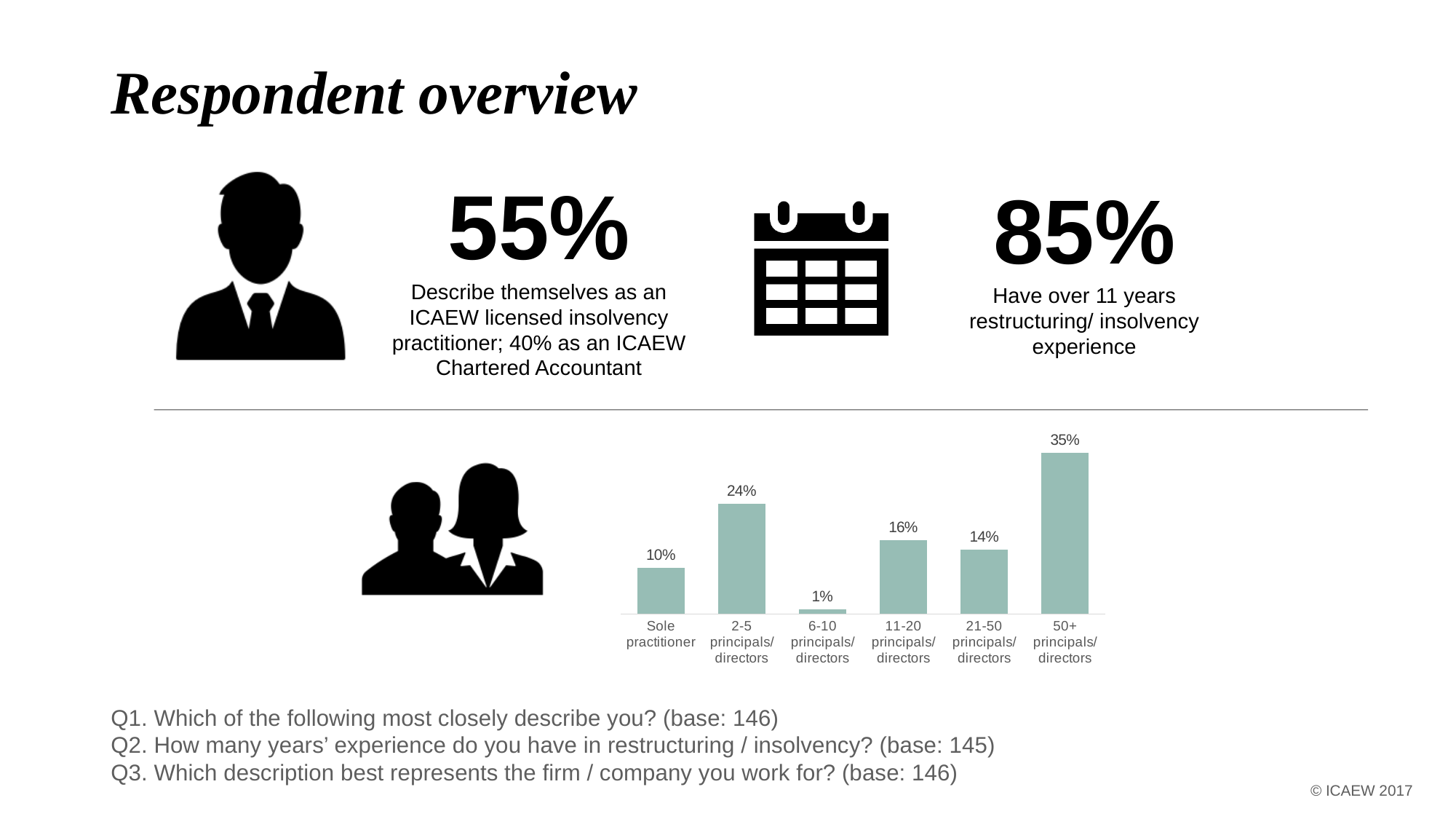
What is the value for 6-10 principals/directors in the bar chart? 1% What is the value for Sole practitioner in the bar chart? 10% How many categories are shown in the bar chart? 6 Which category has the highest value in the bar chart? 50+ principals/directors What is the value for 21-50 principals/directors in the bar chart? 14% Which is larger in the bar chart: the value for 11-20 principals/directors or 21-50 principals/directors? 11-20 principals/directors Which category has the lowest value in the bar chart? 6-10 principals/directors What is the difference between the values for Sole practitioner and 6-10 principals/directors in the bar chart? 9% What is the difference between the values for 50+ principals/directors and 2-5 principals/directors in the bar chart? 11% What is the value for 2-5 principals/directors in the bar chart? 24% What kind of chart is shown on the slide? Bar chart What is the value for 11-20 principals/directors in the bar chart? 16%